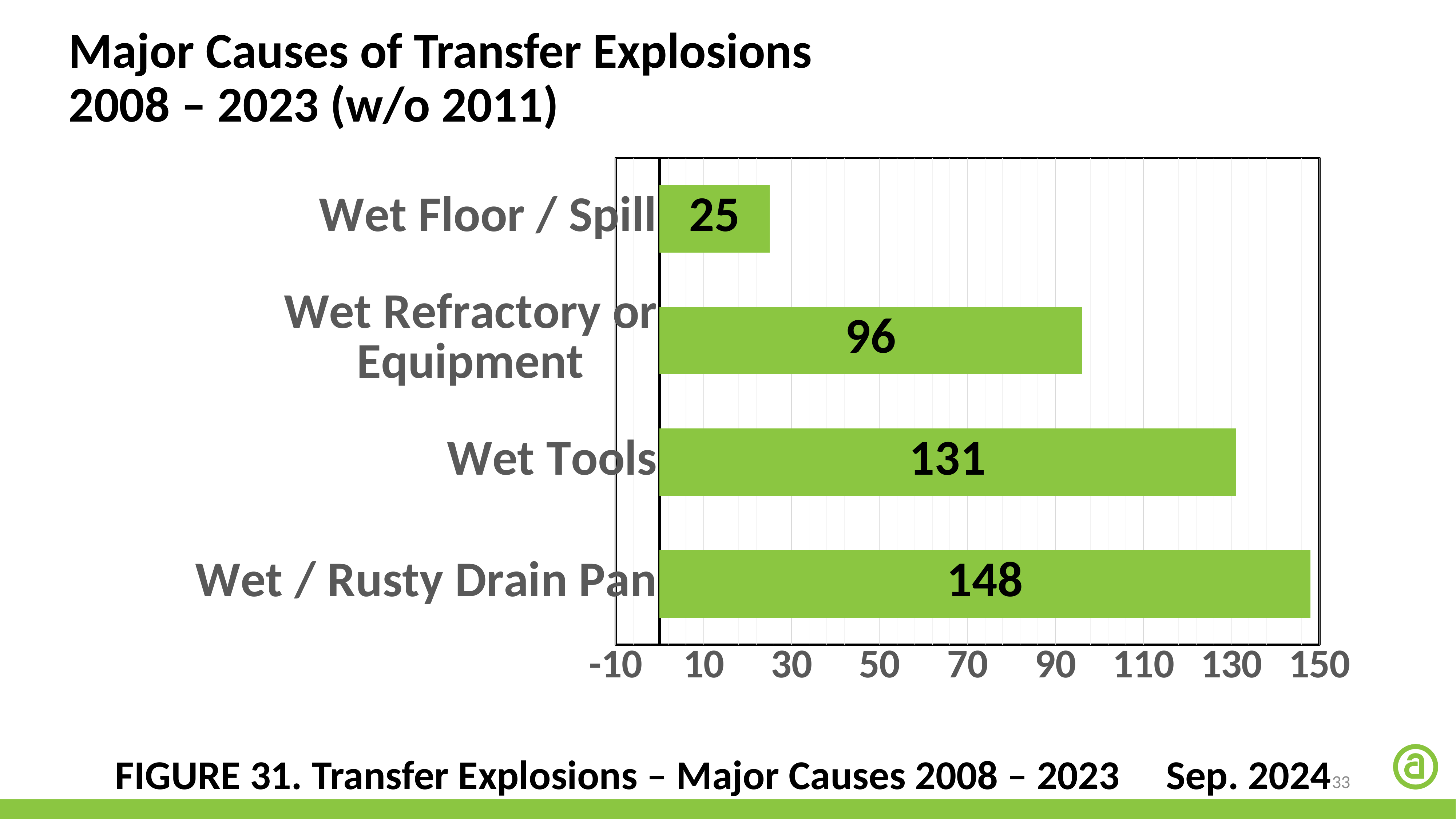
Which cause has the highest value? Wet / Rusty Drain Pan What is the value for Wet Refractory or Equipment? 96 What is the value for Wet / Rusty Drain Pan? 148 What is the value for Wet Floor / Spill? 25 What is the difference between the values for Wet Tools and Wet Refractory or Equipment? 35 Is the value for Wet Refractory or Equipment greater or less than 110? less What is the difference between the values for Wet / Rusty Drain Pan and Wet Tools? 17 What kind of chart is shown on the slide? bar chart Which cause has the lowest value? Wet Floor / Spill Which is larger, the value for Wet Tools or the value for Wet Refractory or Equipment? Wet Tools How many causes are shown in the chart? 4 What is the value for Wet Tools? 131